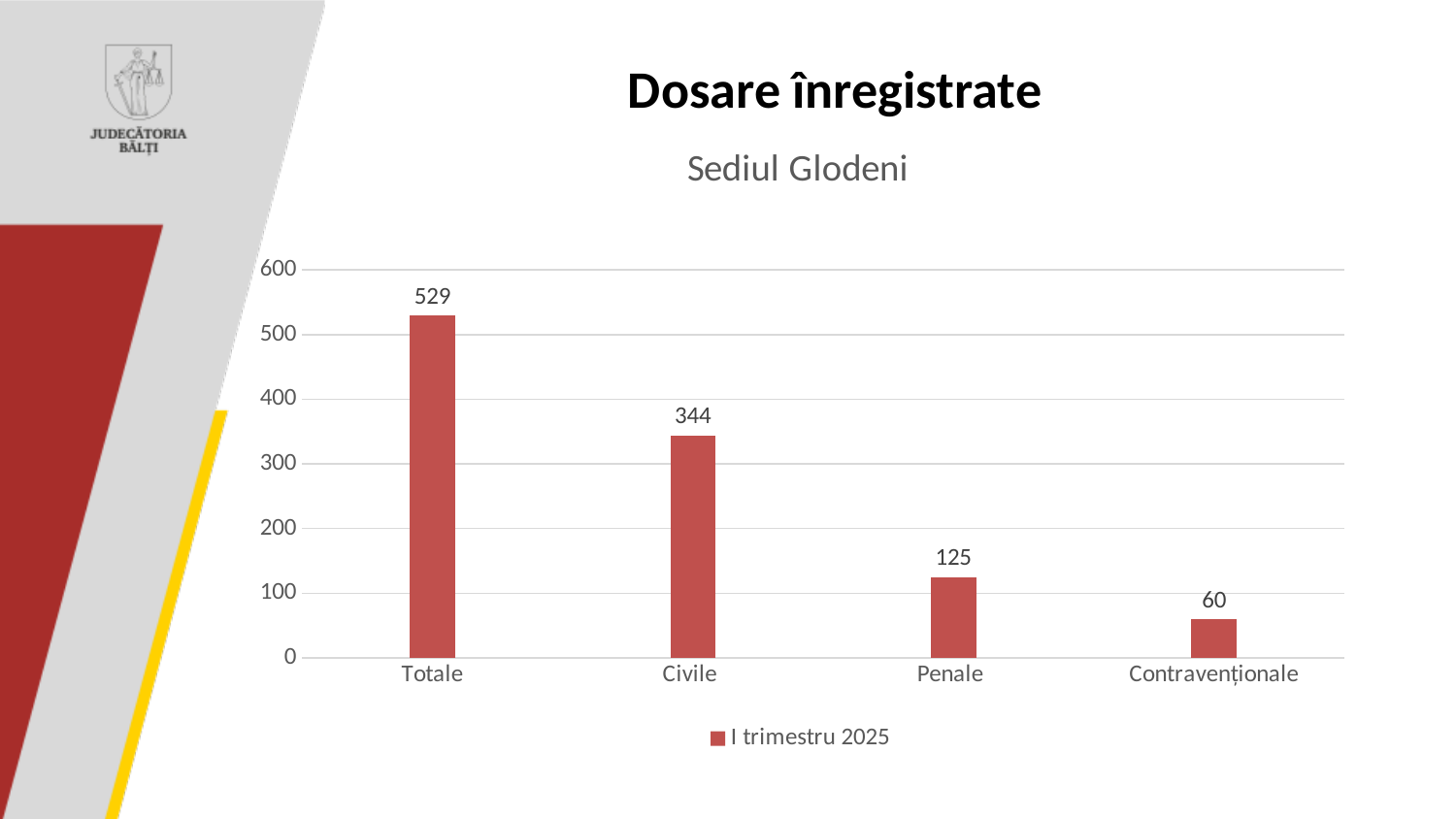
What is the value for Penale? 125 What is the value for Totale? 529 What series does the legend list? I trimestru 2025 What is the value for Civile? 344 What kind of chart is shown on the slide? bar chart Which category has the lowest value? Contravenționale What is the value for Contravenționale? 60 Is the value for Civile greater or less than 300? greater How many categories are shown on the x axis? 4 What is the difference between the values for Civile and Penale? 219 Which category has the highest value? Totale Which is larger, the value for Penale or the value for Contravenționale? Penale